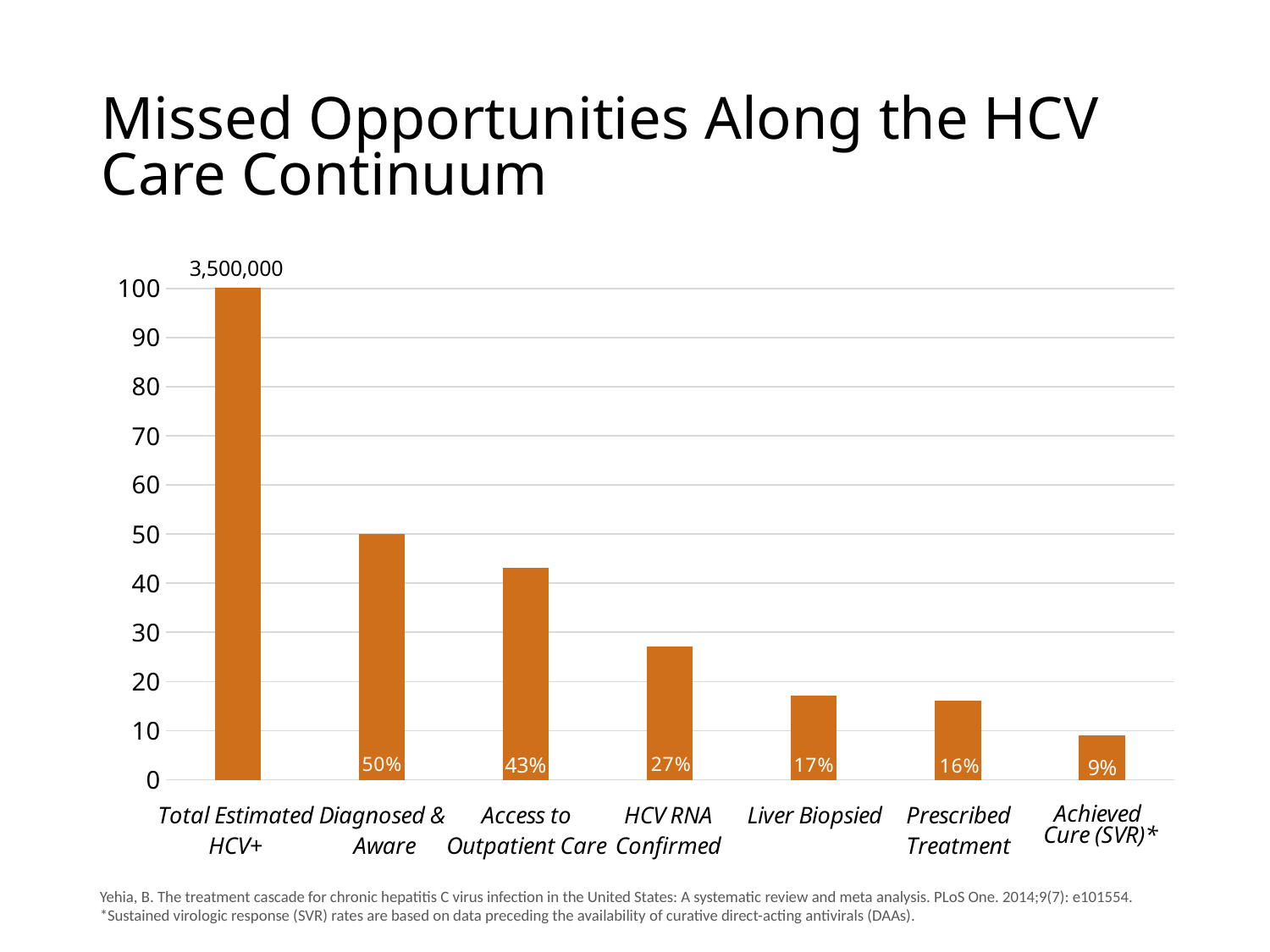
Which category has the highest bar? Total Estimated HCV+ Which category has the lowest value? Achieved Cure (SVR)* Is the value for Total Estimated HCV+ greater or less than 90? greater What number is printed above the Total Estimated HCV+ bar? 3,500,000 What value is shown for Diagnosed & Aware? 50% What value is shown for Achieved Cure (SVR)*? 9% What value is shown for Access to Outpatient Care? 43% What value is shown for HCV RNA Confirmed? 27% Which is larger, the value for Liver Biopsied or the value for Achieved Cure (SVR)*? Liver Biopsied How many categories are shown on the x axis? 7 What kind of chart is shown on the slide? bar chart What is the difference between the values for Diagnosed & Aware and Access to Outpatient Care? 7%